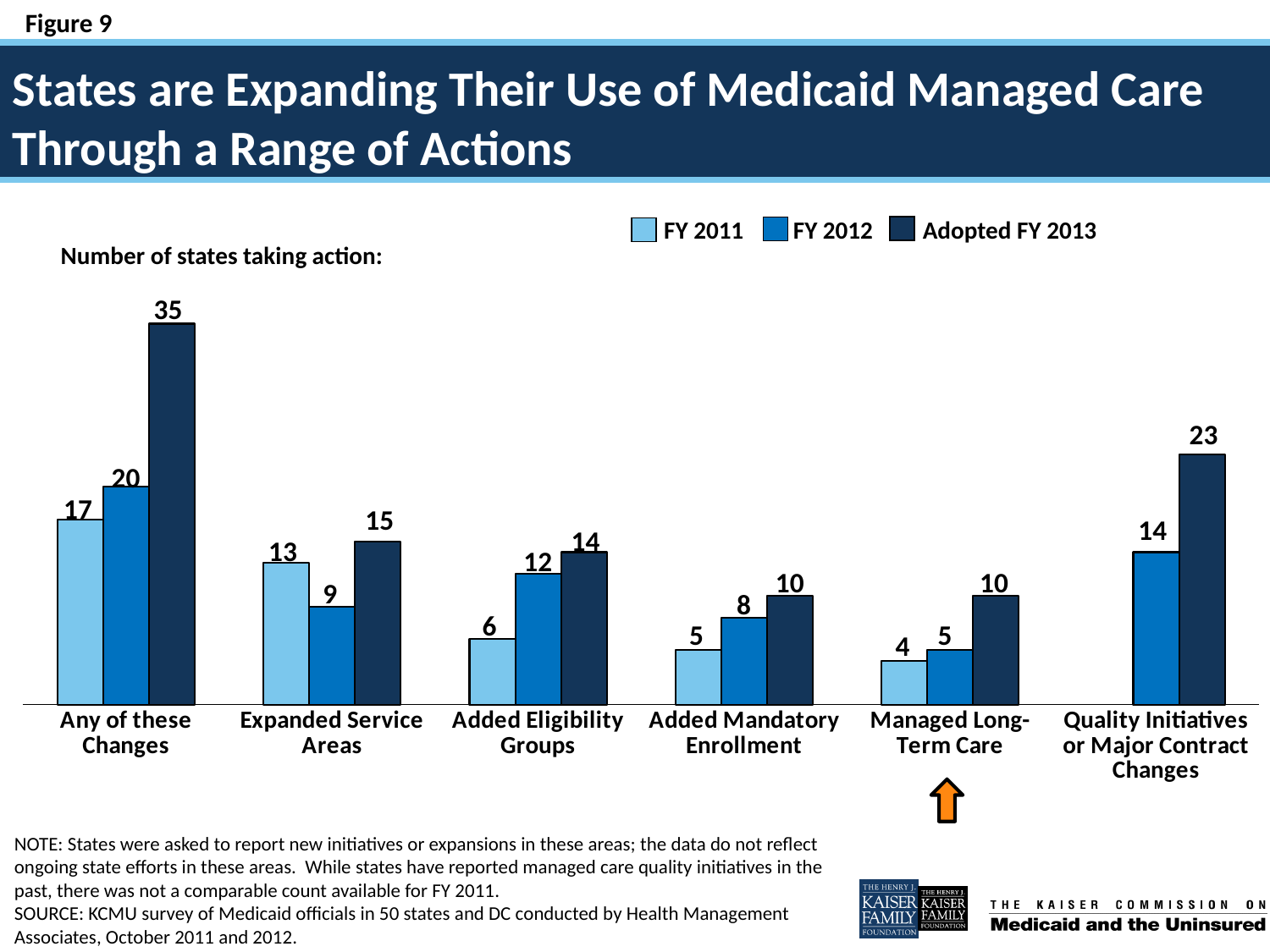
What is the FY 2012 value for Expanded Service Areas? 9 Which category has the highest Adopted FY 2013 value? Any of these Changes Which category has no FY 2011 bar? Quality Initiatives or Major Contract Changes Which is larger for Expanded Service Areas: the FY 2011 value or the FY 2012 value? FY 2011 What is the Adopted FY 2013 value for Any of these Changes? 35 How many categories are shown on the x axis? 6 How many series does the legend list? 3 What is the Adopted FY 2013 value for Quality Initiatives or Major Contract Changes? 23 What is the FY 2011 value for Managed Long-Term Care? 4 Which category has the lowest FY 2011 value? Managed Long-Term Care What kind of chart is shown on the slide? Bar chart What is the difference between the Adopted FY 2013 and FY 2011 values for Any of these Changes? 18